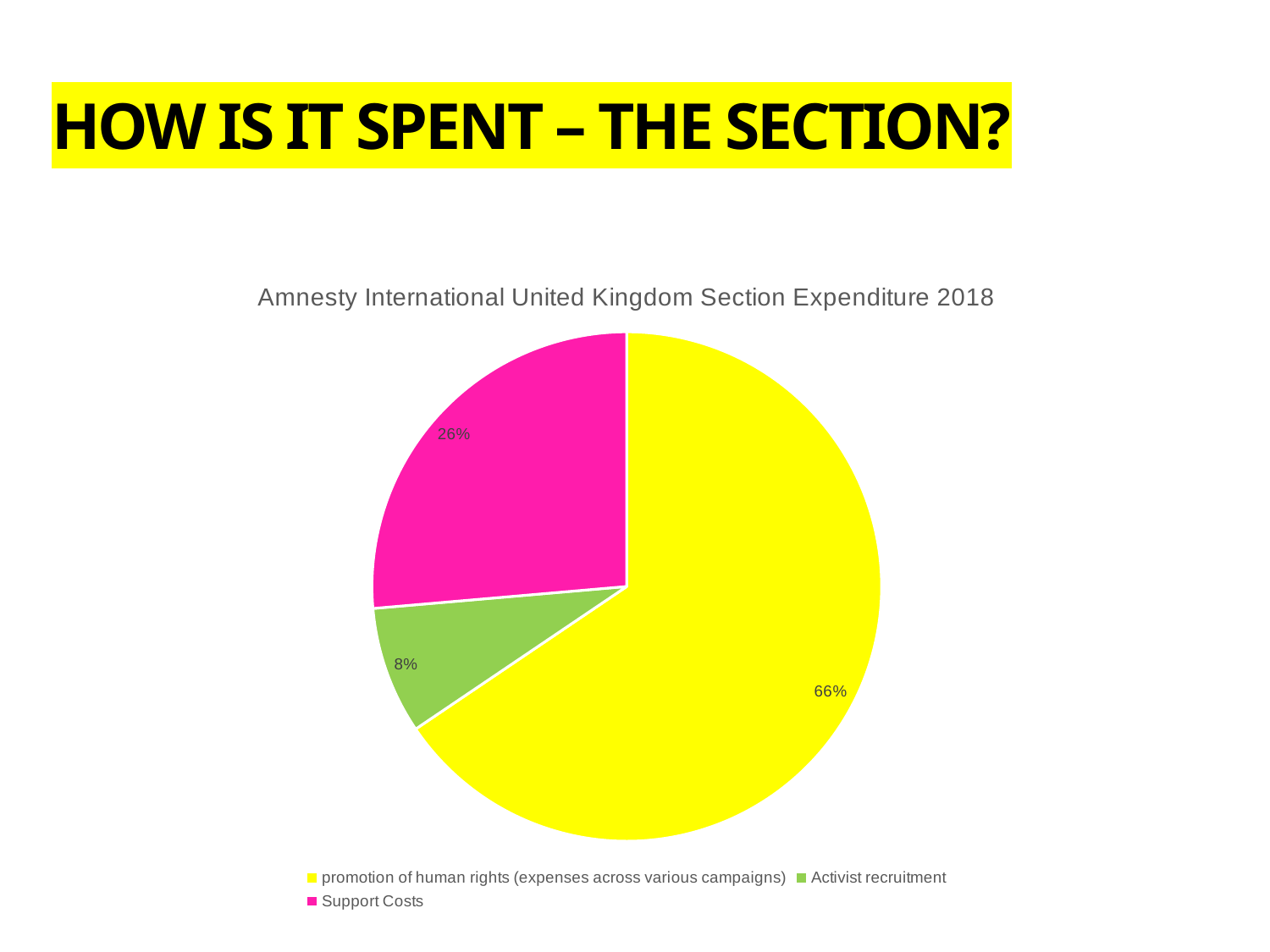
What colour is the slice for Support Costs? pink What kind of chart is shown on the slide? pie chart How many entries does the legend list? 3 What is the difference in percentage points between Support Costs and Activist recruitment? 18 Which is larger, the share for Support Costs or the share for Activist recruitment? Support Costs What is the title of the chart? Amnesty International United Kingdom Section Expenditure 2018 How many slices does the pie chart have? 3 What share of expenditure goes to Support Costs? 26% Which category has the smallest share of expenditure? Activist recruitment Which category has the largest share of expenditure? promotion of human rights (expenses across various campaigns) What share of expenditure goes to Activist recruitment? 8% What share of expenditure goes to promotion of human rights (expenses across various campaigns)? 66%